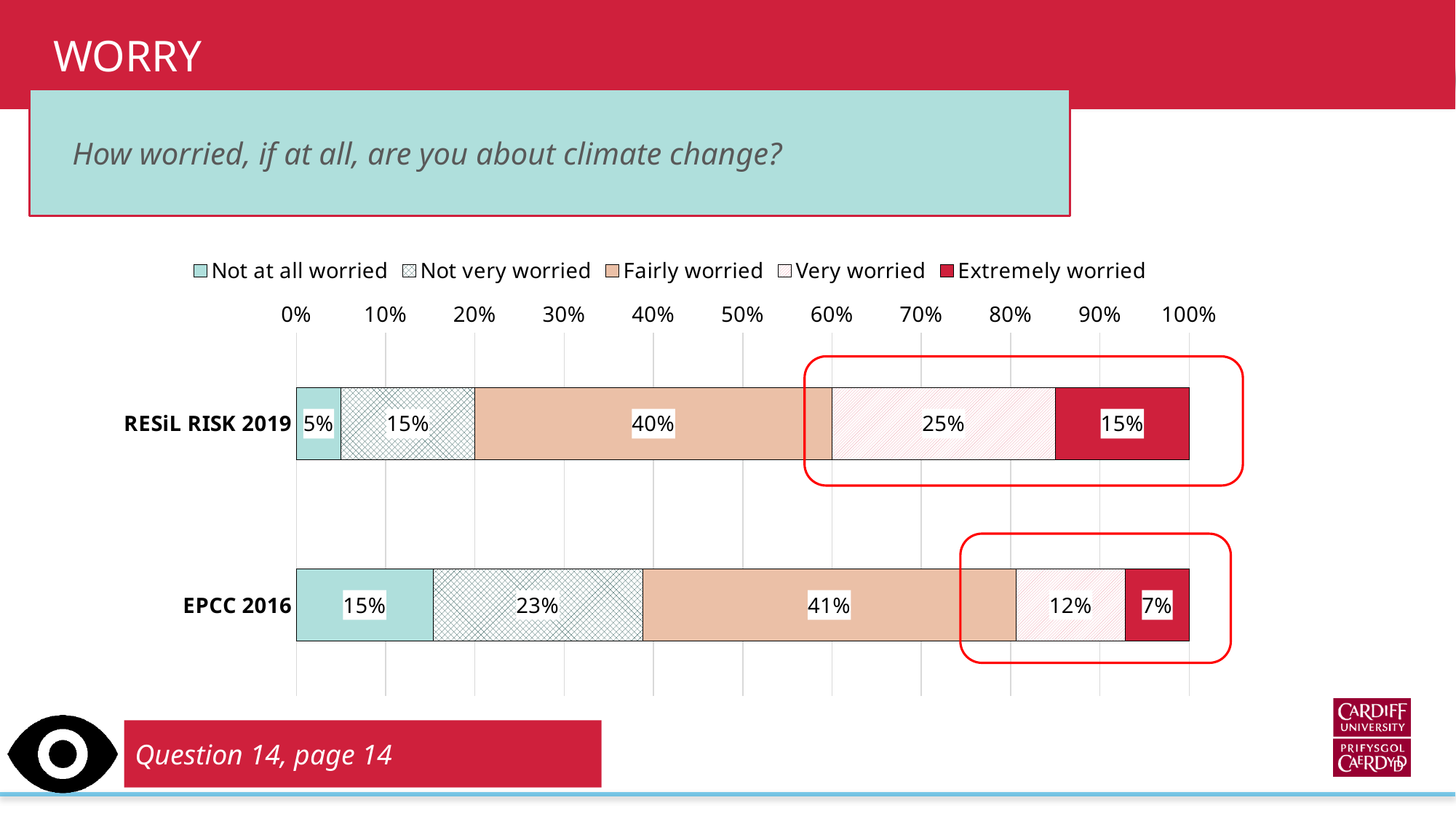
Which response category has the smallest share in the RESiL RISK 2019 bar? Not at all worried What kind of chart is shown on the slide? Stacked bar chart What is the difference between the Very worried share in RESiL RISK 2019 and in EPCC 2016? 13 percentage points What is the combined share of Very worried and Extremely worried in RESiL RISK 2019? 40% Which survey has the larger Not very worried share, RESiL RISK 2019 or EPCC 2016? EPCC 2016 What percentage of RESiL RISK 2019 respondents were Very worried? 25% How many surveys (bars) are shown in the chart? 2 What percentage of EPCC 2016 respondents were Extremely worried? 7% What percentage of RESiL RISK 2019 respondents were Fairly worried? 40% Which response category has the largest share in the EPCC 2016 bar? Fairly worried How many series does the legend list? 5 What percentage of EPCC 2016 respondents were Not at all worried? 15%